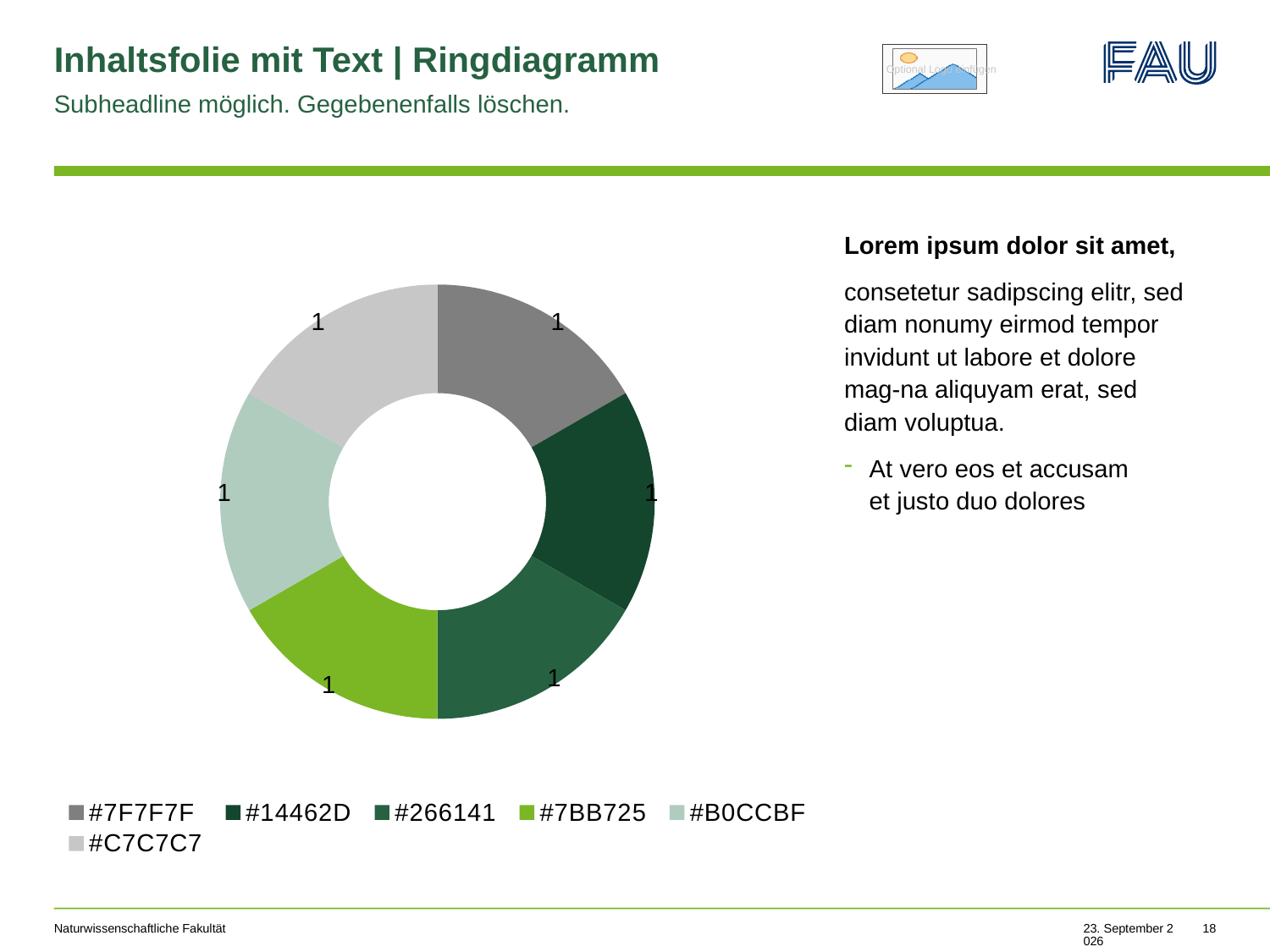
Is the value for #14462D larger than, smaller than, or equal to the value for #266141? Equal What kind of chart is shown on the slide? Doughnut chart What is the value of the #7BB725 segment? 1 What is the value of the #C7C7C7 segment? 1 Which legend entry is listed first? #7F7F7F Which legend entry is listed last? #C7C7C7 What is the total of all segment values in the doughnut chart? 6 How many entries does the chart legend list? 6 How many segments does the doughnut chart have? 6 What is the value of the #7F7F7F segment? 1 Do all segments of the doughnut chart have the same value? Yes What is the difference between the values of #B0CCBF and #7F7F7F? 0